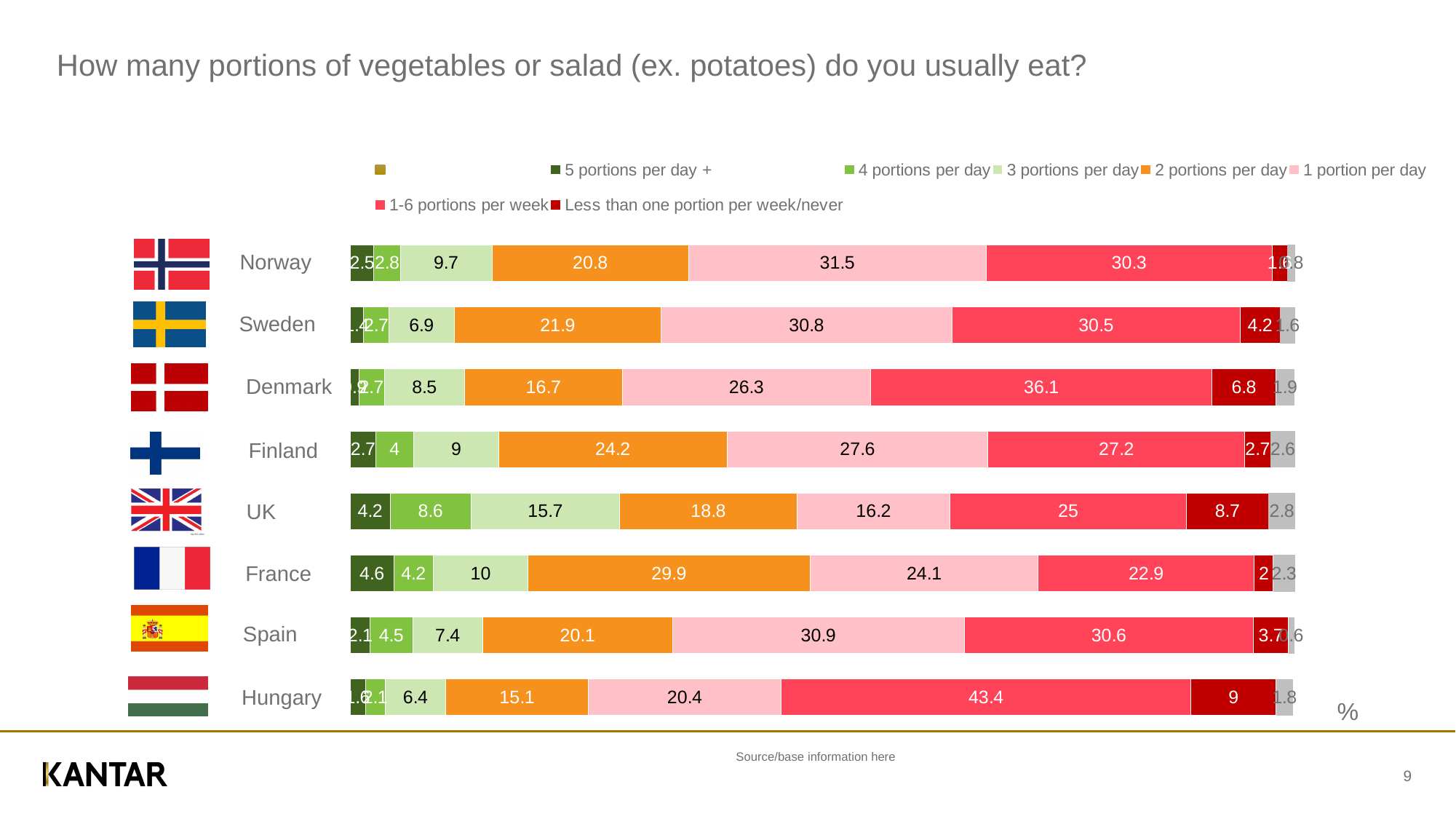
How many countries are shown in the chart? 8 What is the value for '5 portions per day +' for the UK? 4.2 Which is larger: the '1 portion per day' value for Norway or for Sweden? Norway Which country has the highest value for '2 portions per day'? France What colour represents '2 portions per day' in the chart? Orange Which country has the lowest value for '1 portion per day'? UK What is the value for '3 portions per day' for Finland? 9 What is the value for '2 portions per day' for France? 29.9 For Denmark, what is the difference between the '1-6 portions per week' value and the '1 portion per day' value? 9.8 Which country has the highest value for '1-6 portions per week'? Hungary What kind of chart is shown on the slide? Stacked bar chart What is the value for '1-6 portions per week' for Hungary? 43.4